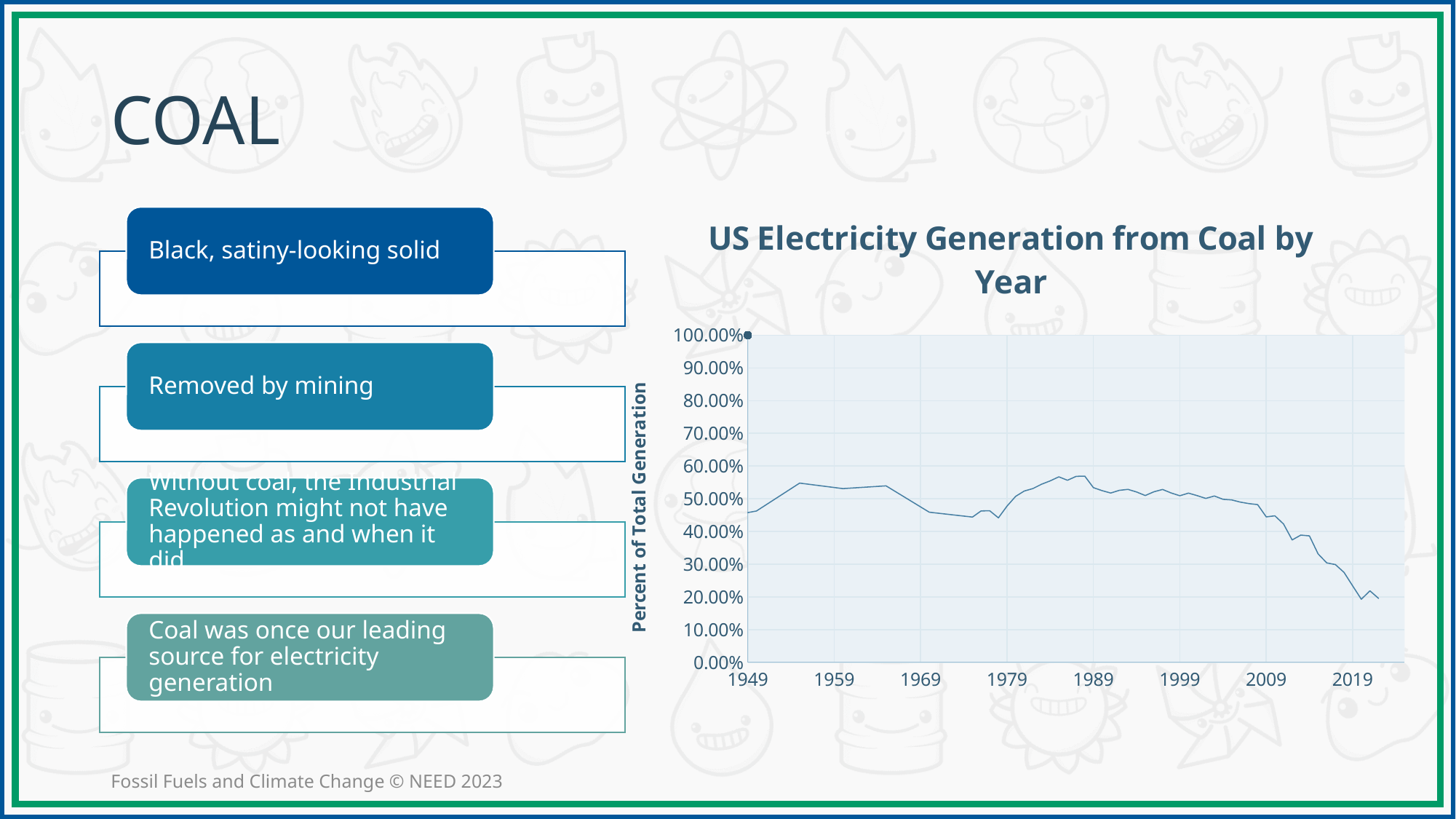
Is the value for 1949 greater or less than 50.00%? less What is the title of the chart on the slide? US Electricity Generation from Coal by Year Is the value for 2009 greater or less than 50.00%? less How many year labels are shown on the horizontal axis of the chart? 8 What is the label on the vertical axis of the chart? Percent of Total Generation Is the value for 2019 greater or less than 30.00%? less Overall, do the values in the chart rise or fall from 1949 to the end of the series? fall Which year has the larger value, 1949 or 2019? 1949 What kind of chart is shown on the slide? line chart